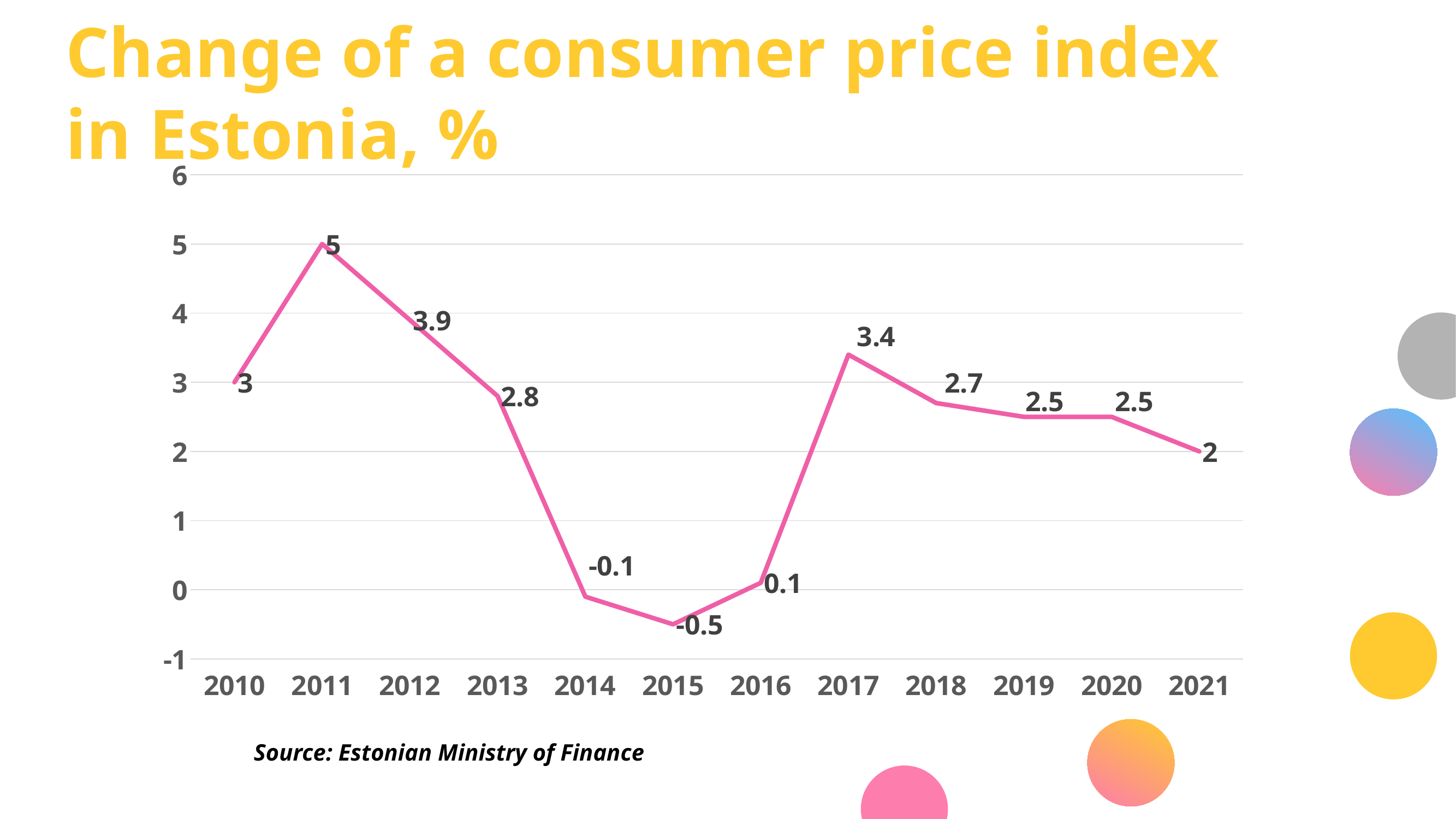
What is the change of the consumer price index in Estonia in 2017? 3.4 What is the change of the consumer price index in Estonia in 2021? 2 Which year has the highest change of the consumer price index? 2011 How many years are plotted on the chart? 12 What is the change of the consumer price index in Estonia in 2011? 5 Which year has a larger value, 2013 or 2018? 2013 What kind of chart is shown on the slide? Line chart What is the difference between the values for 2017 and 2018? 0.7 What is the change of the consumer price index in Estonia in 2015? -0.5 Which year has the lowest change of the consumer price index? 2015 Does the value rise or fall from 2017 to 2021? Fall What is the difference between the values for 2011 and 2012? 1.1